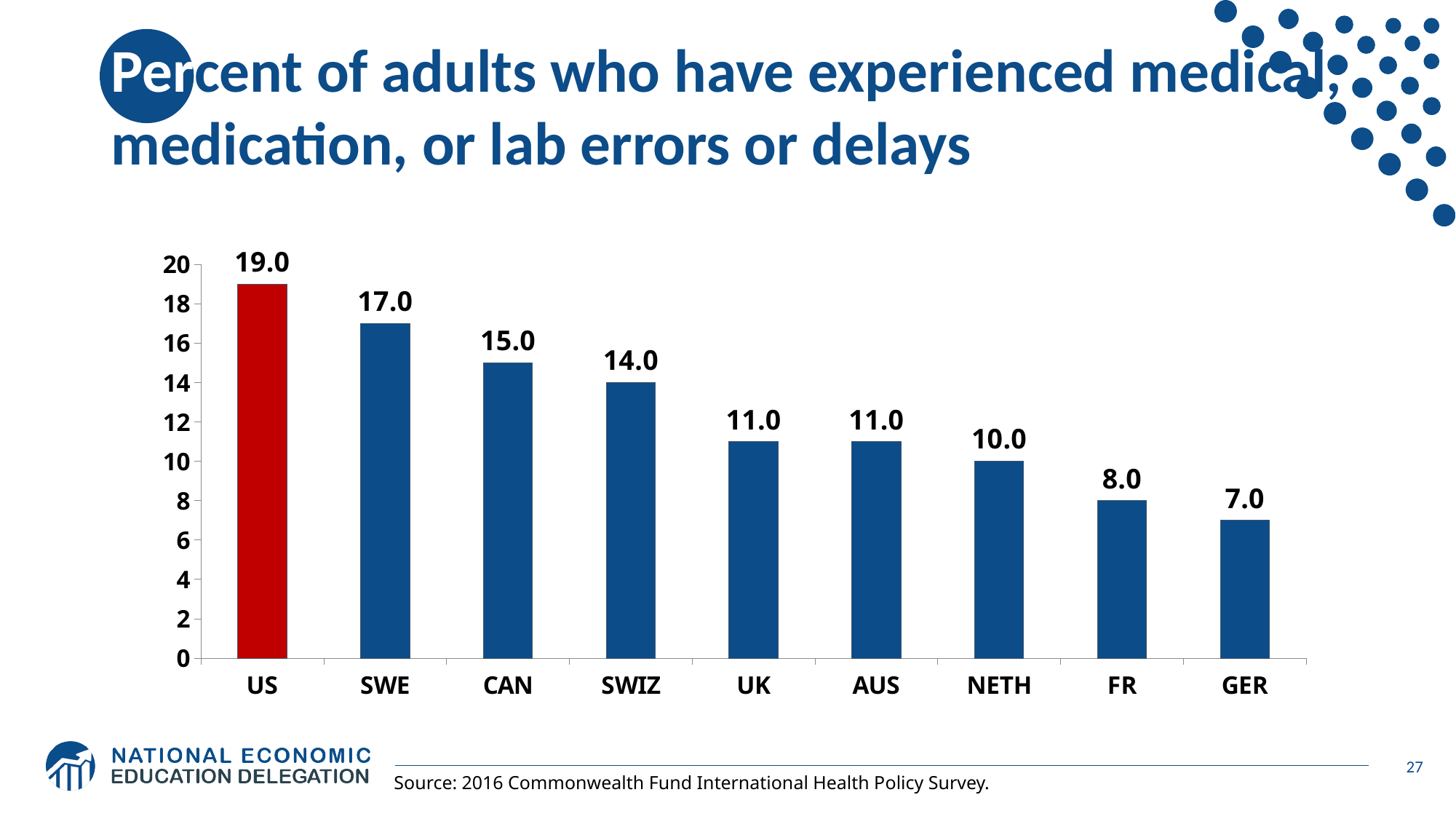
Which country has the lowest value? GER What is the value for NETH? 10.0 Which country has the highest value? US Which bar is coloured red rather than blue? US What kind of chart is shown on the slide? bar chart What is the value for SWIZ? 14.0 What is the difference between the values for the US and SWE? 2.0 What is the difference between the values for CAN and GER? 8.0 Which is larger, the value for FR or the value for NETH? NETH Do the values rise or fall from left to right along the x axis? fall What is the value for the US? 19.0 How many countries are shown on the chart? 9